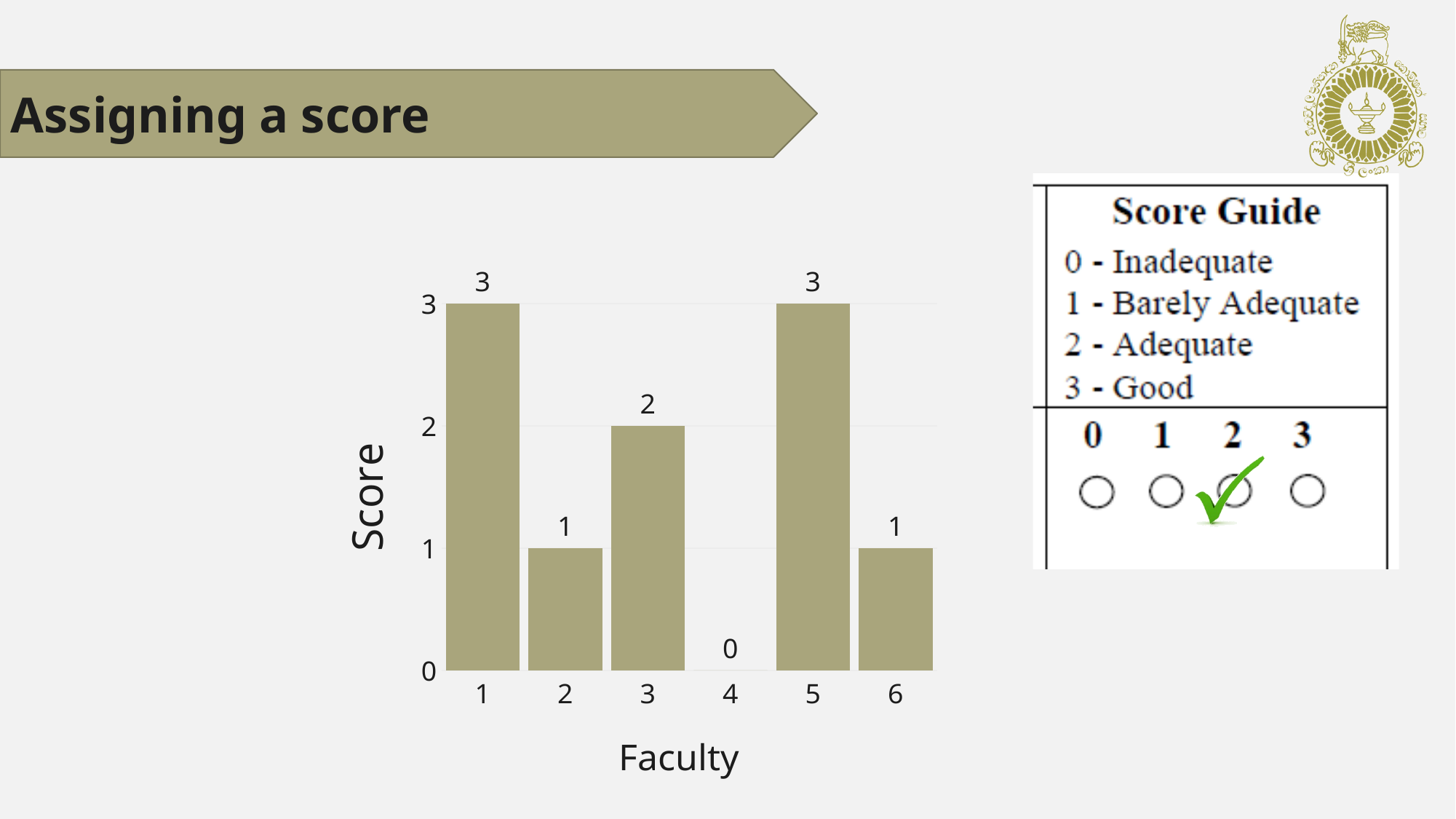
What is the score for Faculty 1? 3 Which has a higher score, Faculty 3 or Faculty 6? Faculty 3 What is the score for Faculty 3? 2 Which faculty has the lowest score? 4 What is the label of the x axis? Faculty What is the score for Faculty 6? 1 What is the label of the y axis? Score What kind of chart is shown on the slide? Bar chart What is the difference between the scores of Faculty 1 and Faculty 2? 2 How many faculties are shown on the x axis? 6 Which faculties share the highest score? 1 and 5 What is the score for Faculty 4? 0